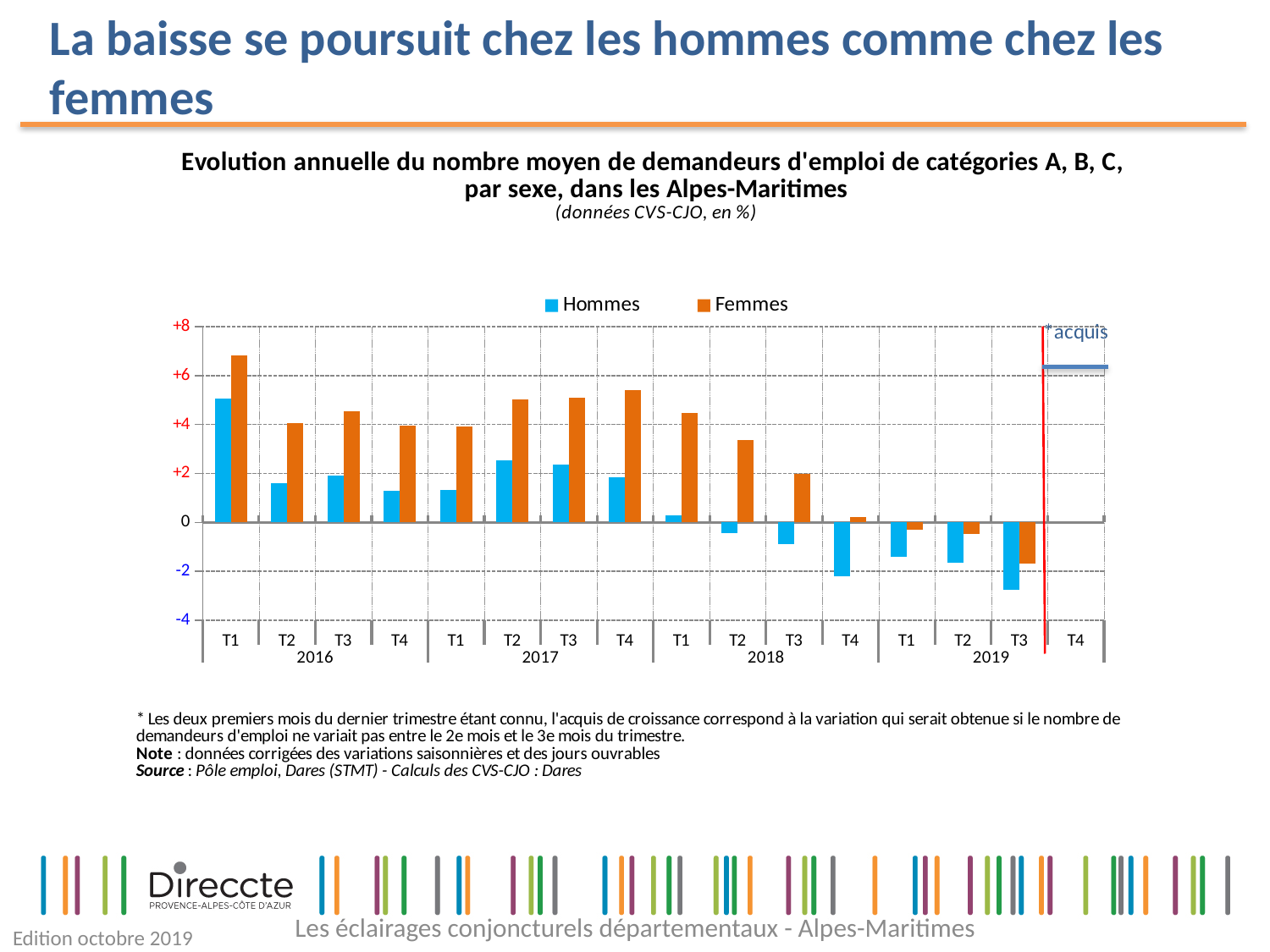
In which quarter is the Hommes value highest? T1 2016 For T3 2018, which series has the larger value, Hommes or Femmes? Femmes How many years are labelled along the x axis? 4 What kind of chart is shown on the slide? bar chart How many series does the legend list? 2 Do the Femmes values rise or fall from T4 2017 to T3 2019? fall Is the Femmes value for T1 2016 greater or less than +6? greater Is the Femmes value for T4 2017 greater or less than +4? greater In which quarter is the Femmes value lowest? T3 2019 What are the two series named in the legend? Hommes and Femmes In which quarter is the Femmes value highest? T1 2016 Is the Hommes value for T3 2019 greater or less than -2? less